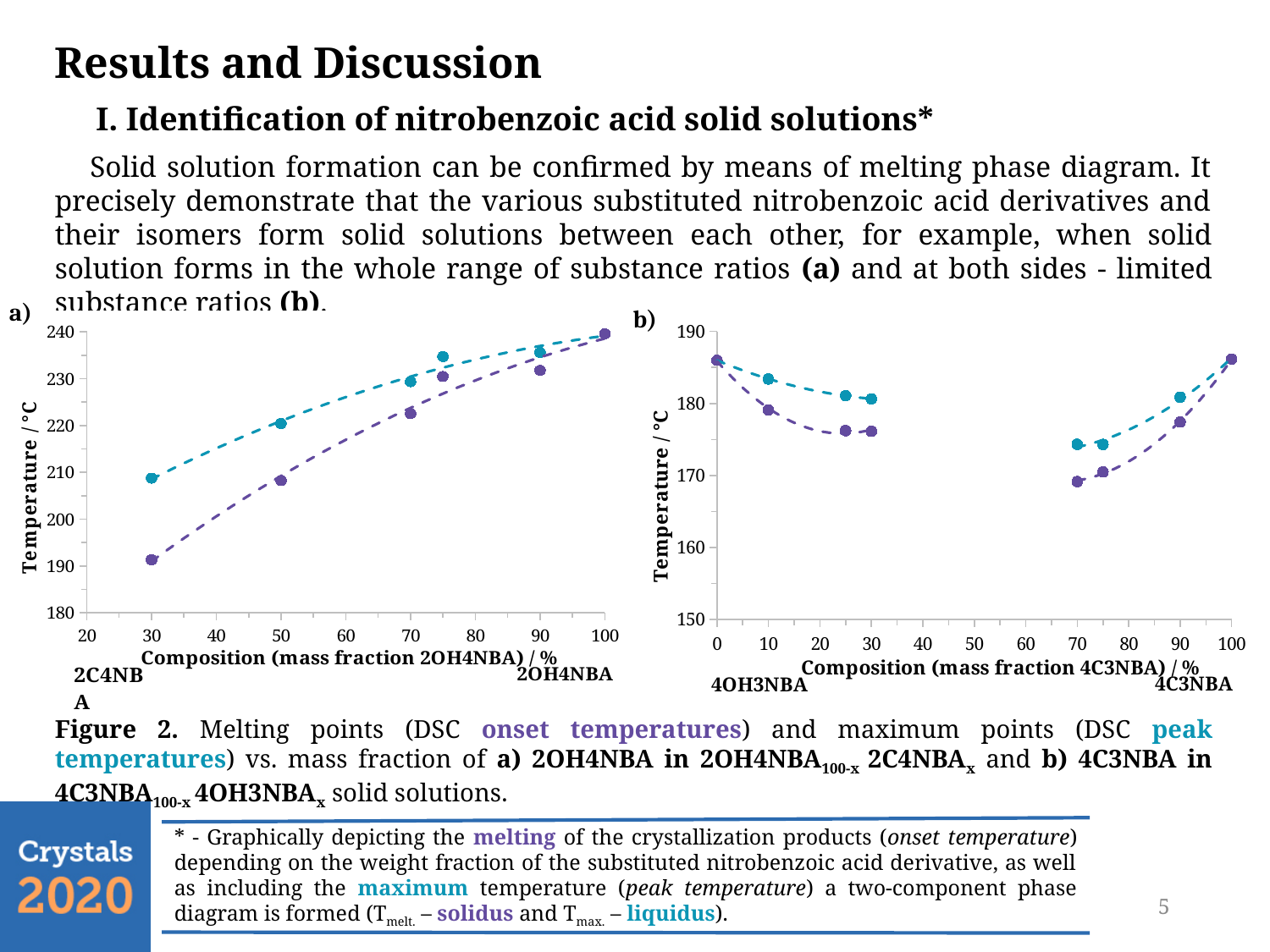
How many distinct composition values have data points plotted in chart a)? 6 What is the x-axis title of chart a)? Composition (mass fraction 2OH4NBA) / % In chart b), do the temperatures rise or fall as the composition goes from 0 to 30? fall In chart a), do the temperatures rise or fall as the mass fraction of 2OH4NBA increases? rise What kind of chart is chart a) on the left? scatter chart In chart a), is the lower (purple) point at composition 30 greater or less than 200? less In chart b), is the lower (purple) point at composition 25 greater or less than 180? less In chart a), is the upper (teal) point at composition 30 greater or less than 200? greater In chart b), at composition 10, which series has the higher value, the teal or the purple one? teal How many distinct composition values have data points plotted in chart b)? 8